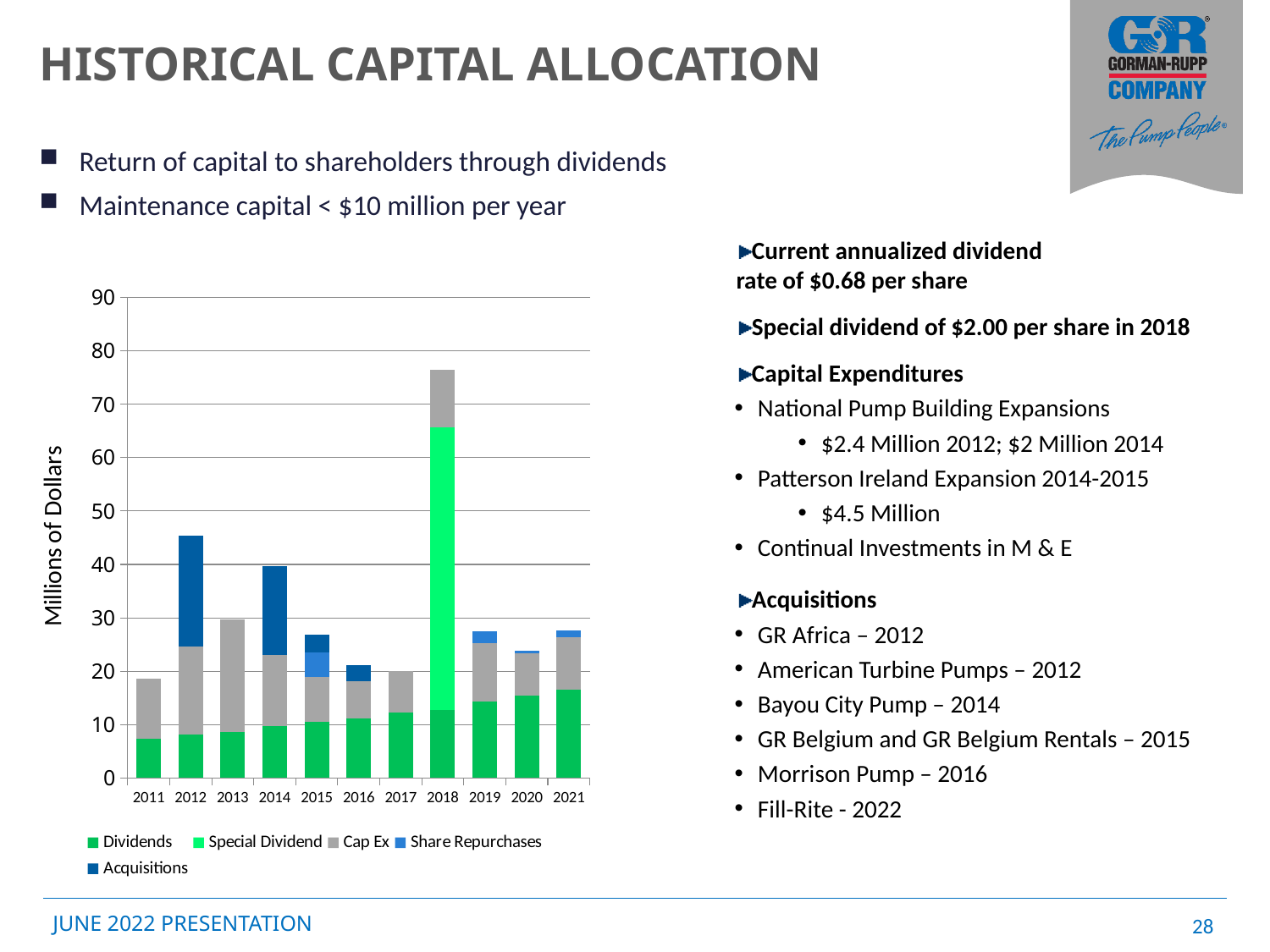
Which year has the highest total bar in the chart? 2018 What is the label on the y axis of the chart? Millions of Dollars What kind of chart is shown on the slide? Stacked bar chart Do the Dividends values generally rise or fall from 2011 to 2021? rise How many years are shown on the x axis of the chart? 11 Is the total bar for 2011 greater or less than 20? less Which year has the larger total bar, 2012 or 2013? 2012 Is the total bar for 2012 greater or less than 40? greater Is the total bar for 2018 greater or less than 70? greater How many series does the chart legend list? 5 Which year has the lowest total bar in the chart? 2011